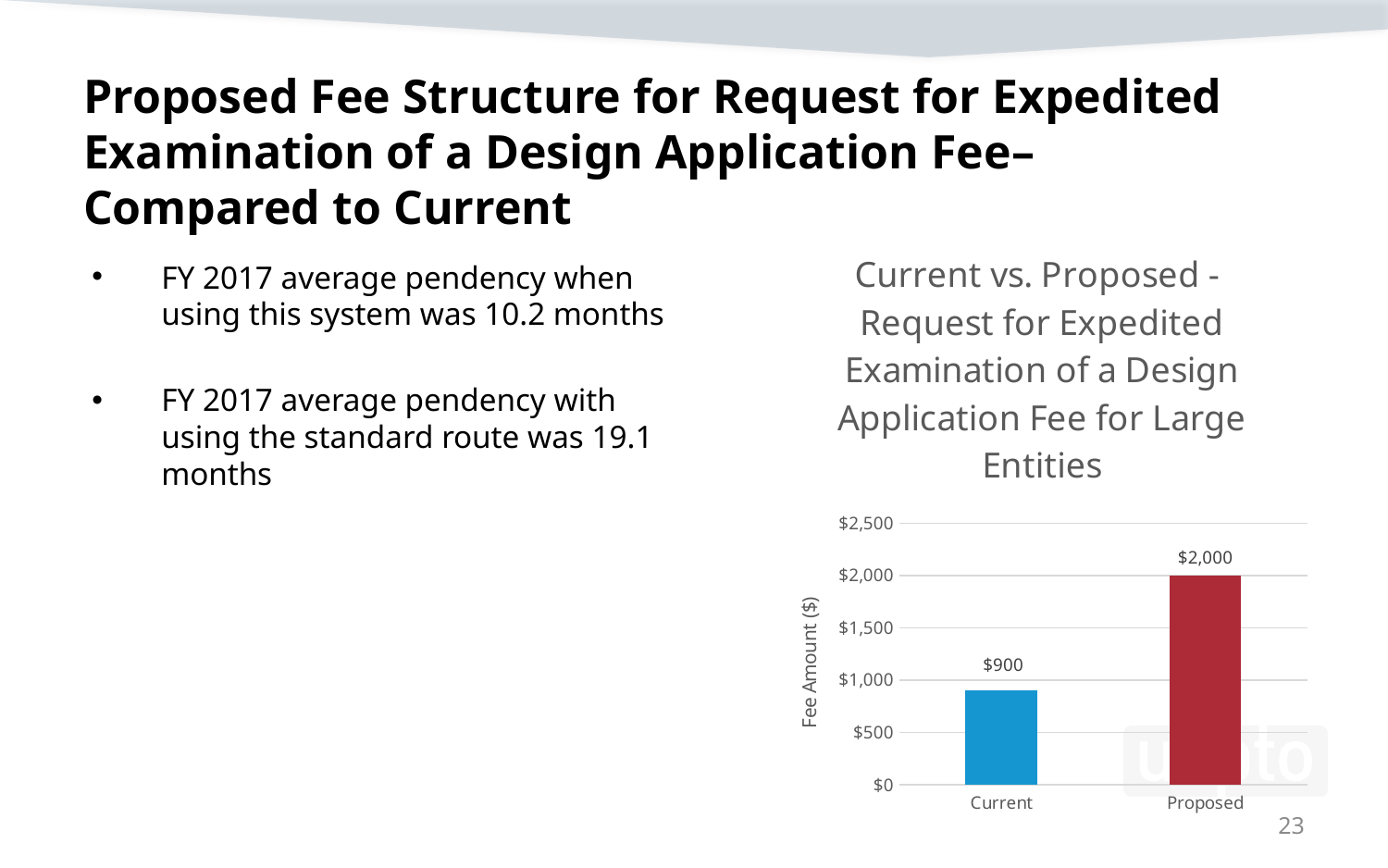
What is the label of the vertical axis of the chart? Fee Amount ($) Is the Current fee amount larger or smaller than the Proposed fee amount? smaller What is the title of the chart? Current vs. Proposed - Request for Expedited Examination of a Design Application Fee for Large Entities What is the fee amount for the Proposed category? $2,000 What is the difference between the Proposed and Current fee amounts? $1,100 Which category has the lower fee amount? Current Which category has the higher fee amount? Proposed Is the value for Proposed greater or less than $1,500? greater Is the value for Current greater or less than $1,000? less What kind of chart is shown on the slide? bar chart What is the fee amount for the Current category? $900 How many categories are shown on the x axis of the chart? 2